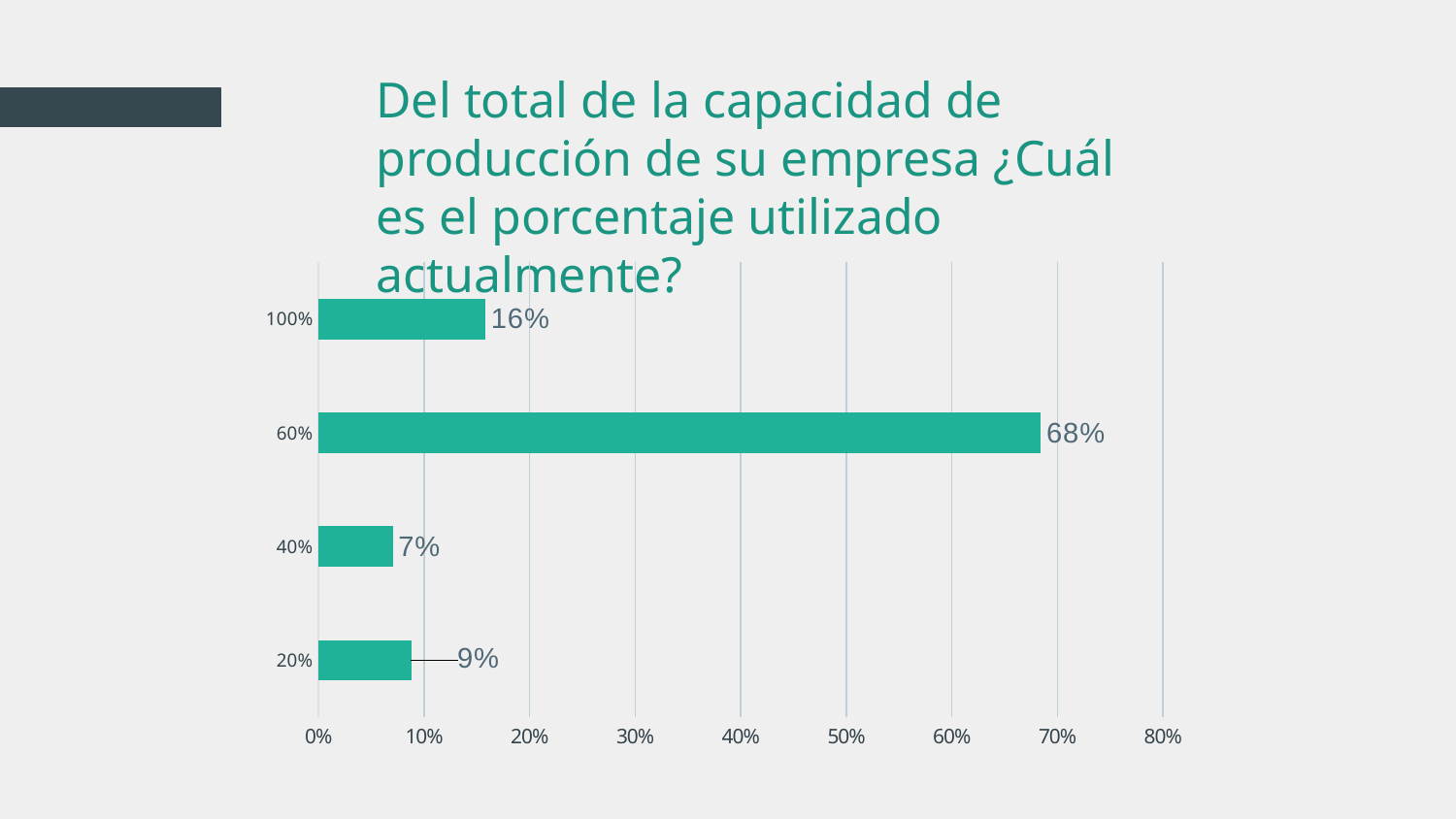
Which capacity category has the highest value? 60% What is the value shown for the 20% capacity category? 9% What kind of chart is shown on the slide? Bar chart What is the highest value shown on the horizontal axis? 80% What is the value shown for the 100% capacity category? 16% Which capacity category has the lowest value? 40% What is the difference between the values for the 60% and 100% categories? 52% Which has a larger value, the 20% category or the 40% category? 20% What is the value shown for the 40% capacity category? 7% What percentage of respondents reported using 60% of their production capacity? 68% How many capacity categories are shown in the chart? 4 Is the value for the 60% category greater or less than 50%? greater